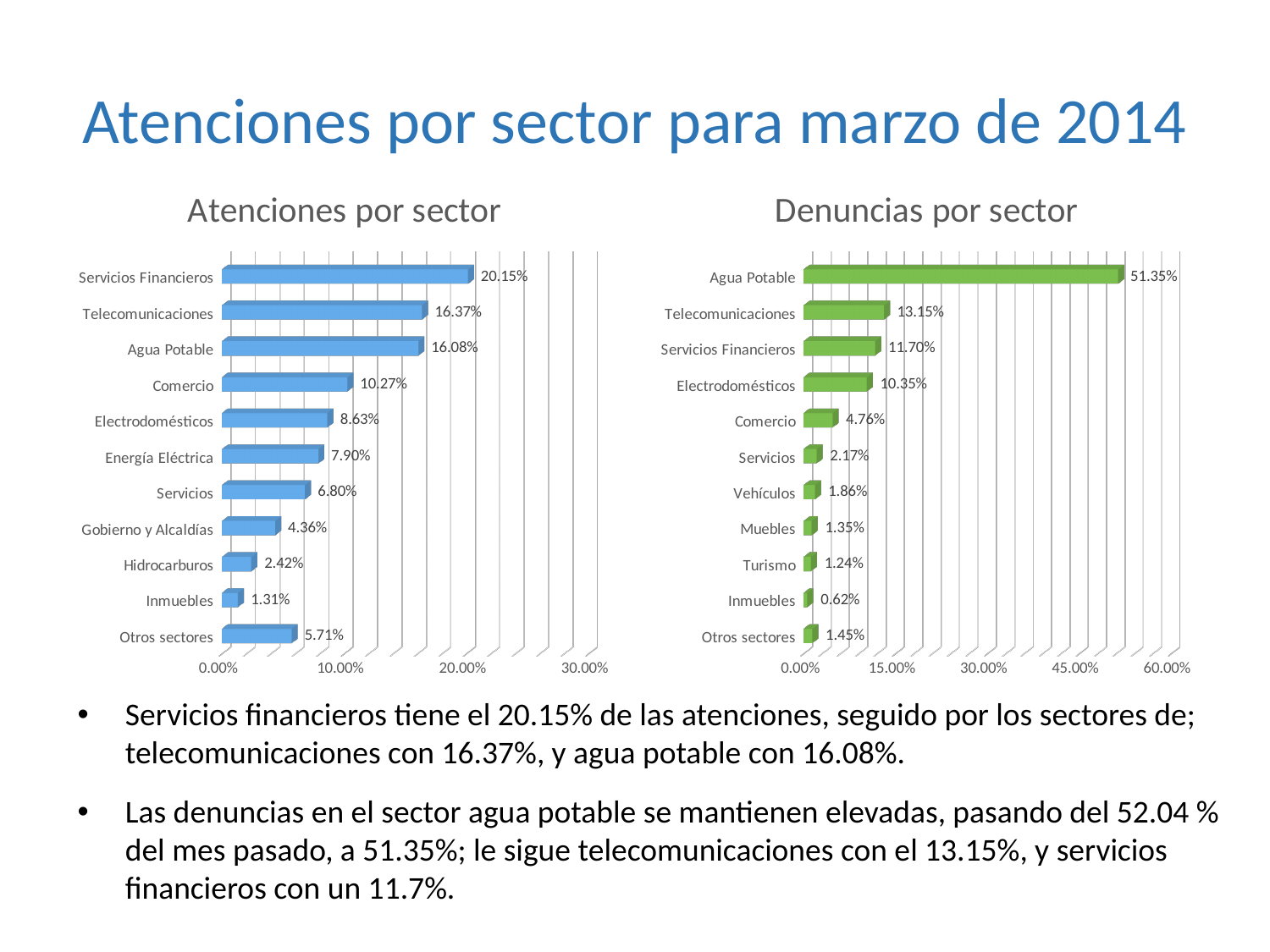
In the 'Atenciones por sector' chart, what is the value for Servicios Financieros? 20.15% What colour are the bars in the 'Denuncias por sector' chart? Green In the 'Denuncias por sector' chart, what is the value for Agua Potable? 51.35% In the 'Atenciones por sector' chart, what is the difference between Telecomunicaciones and Agua Potable? 0.29% In the 'Atenciones por sector' chart, which category has the lowest value? Inmuebles How many categories are shown in the 'Denuncias por sector' chart? 11 In the 'Atenciones por sector' chart, is the value for Comercio greater or less than 10.00%? greater What kind of chart is 'Atenciones por sector'? Bar chart In the 'Denuncias por sector' chart, which is larger: Telecomunicaciones or Servicios Financieros? Telecomunicaciones In the 'Denuncias por sector' chart, what is the value for Inmuebles? 0.62% In the 'Atenciones por sector' chart, what is the value for Otros sectores? 5.71% In the 'Denuncias por sector' chart, which category has the highest value? Agua Potable